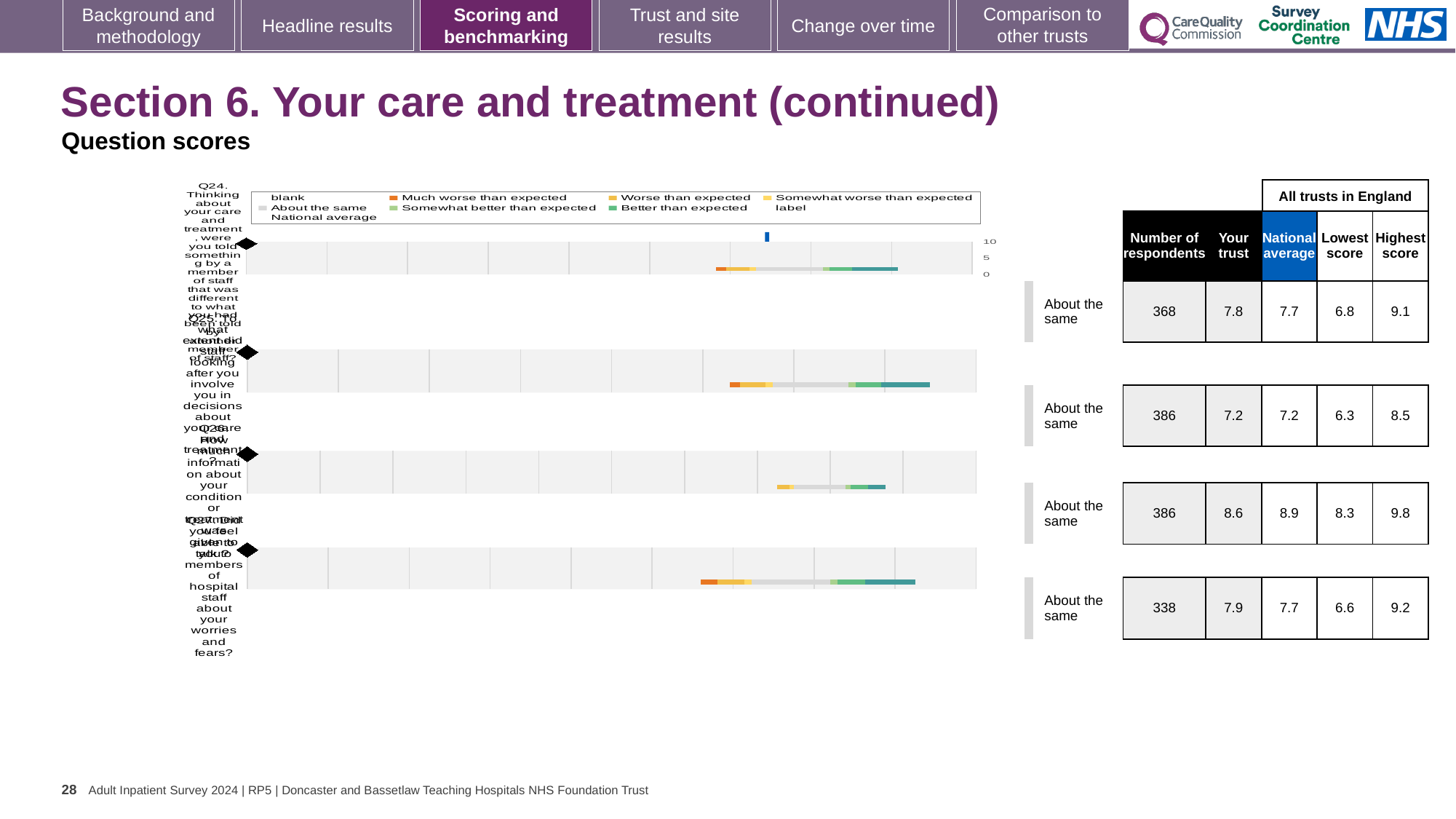
What kind of chart is used to show the question scores on this slide? bar chart Which question has the highest 'Your trust' score in the table beside the chart? Q26 What is the national average score for Q26 in the table beside the chart? 8.9 According to the table beside the chart, how many respondents answered Q27? 338 Which question has the lowest 'Your trust' score in the table beside the chart? Q25 What is the lowest score across all trusts in England for Q25? 6.3 How many questions (rows) are plotted in the chart? 4 According to the table beside the chart, what is the 'Your trust' score for Q24? 7.8 For Q24, which is larger: the 'Your trust' score or the national average? Your trust For Q27, how much higher is the 'Your trust' score than the national average? 0.2 For Q26, what is the difference between the highest score and the lowest score across all trusts in England? 1.5 What benchmark category is shown for all four questions on this slide? About the same